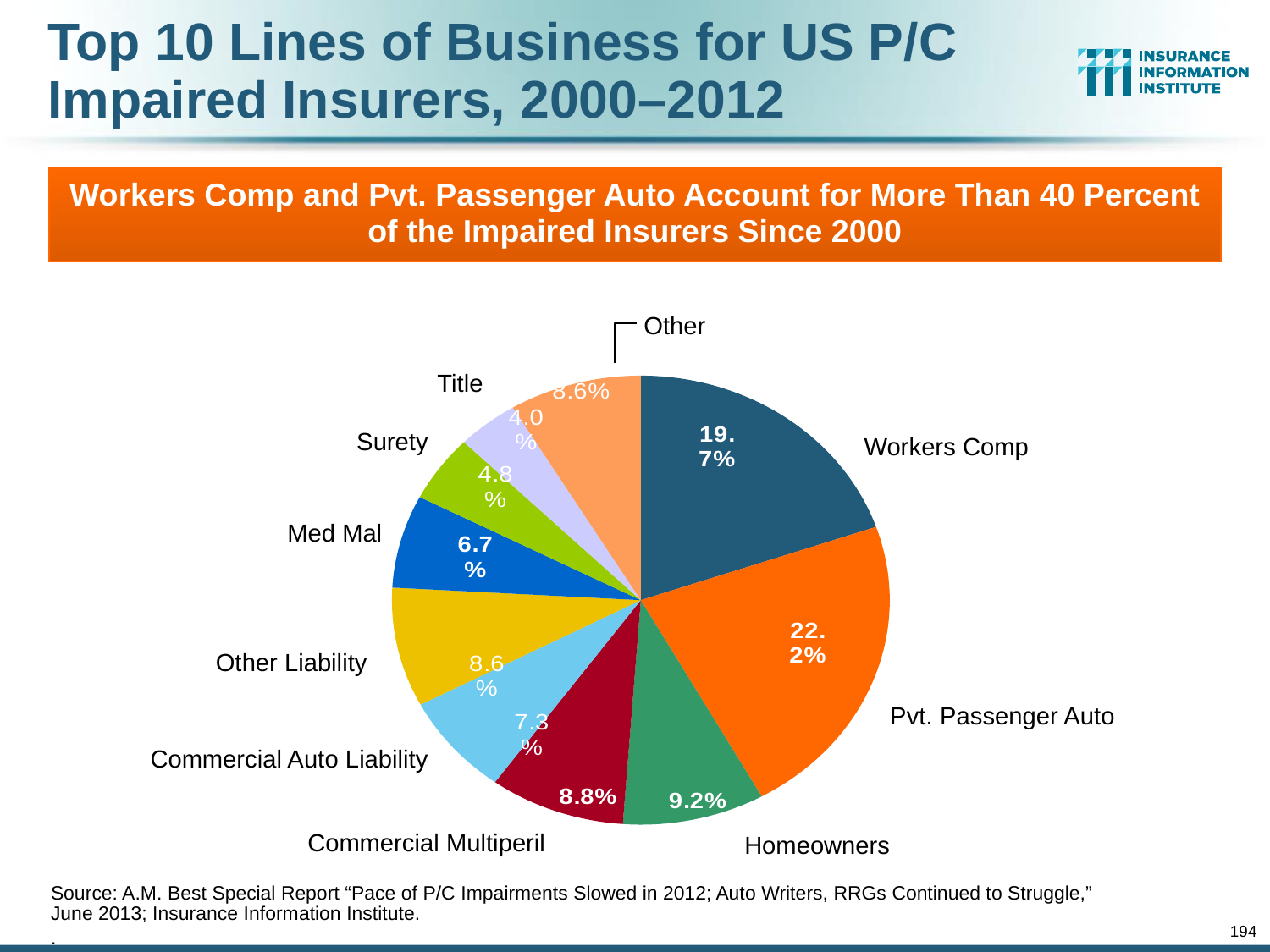
What is the combined share of Workers Comp and Pvt. Passenger Auto? 41.9% What kind of chart is shown on the slide? pie chart How many slices does the pie chart have? 10 What is the value shown for Title? 4.0% What is the difference between the Pvt. Passenger Auto share and the Workers Comp share? 2.5% Which line of business has the smallest slice of the pie? Title What is the value shown for Homeowners? 9.2% Which is larger, the share for Commercial Multiperil or the share for Commercial Auto Liability? Commercial Multiperil What share of impaired insurers is attributed to Workers Comp? 19.7% Which line of business has the largest slice of the pie? Pvt. Passenger Auto What share of impaired insurers is attributed to Pvt. Passenger Auto? 22.2% What is the value shown for Med Mal? 6.7%